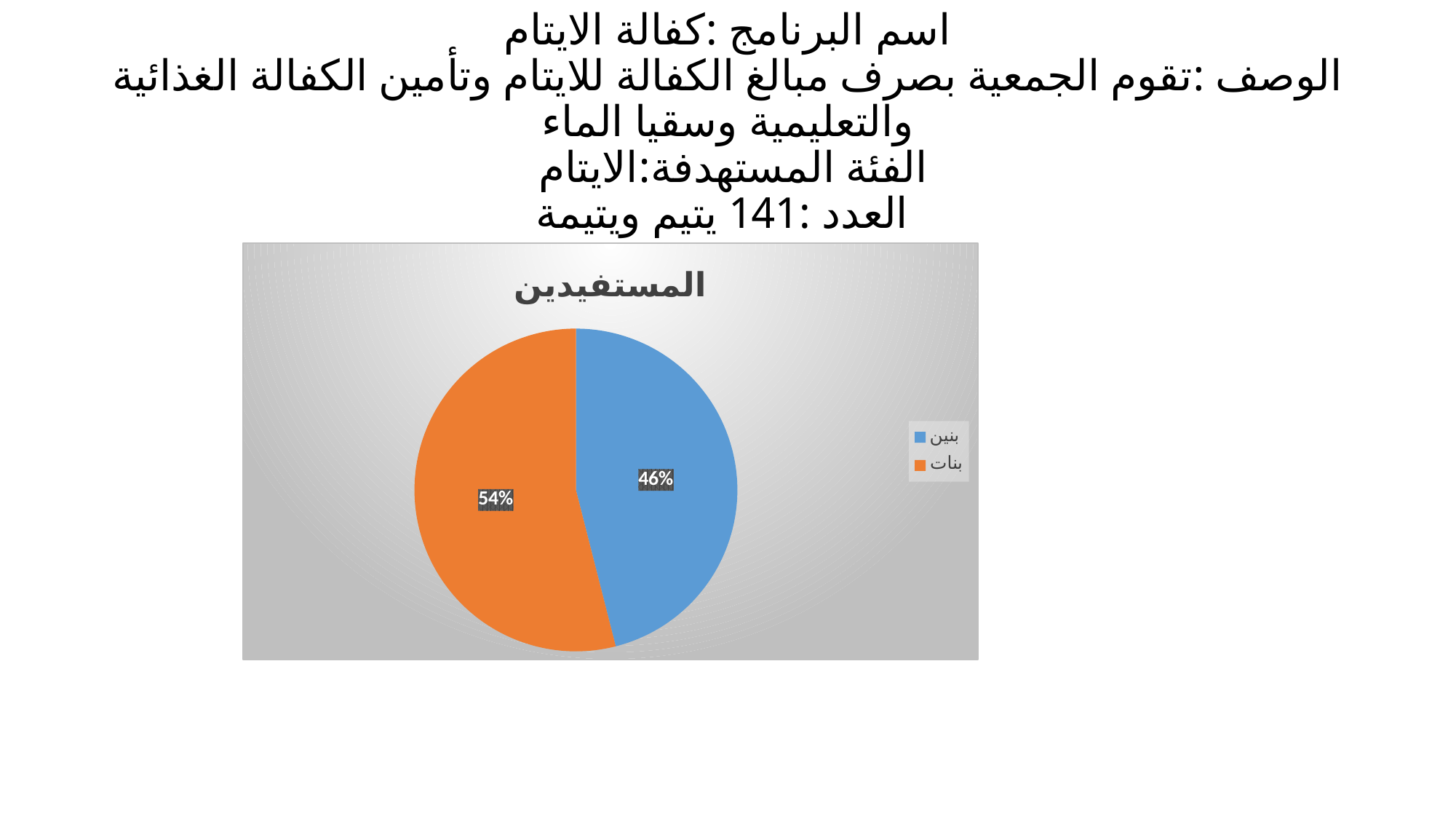
What share of the pie does بنات (girls) represent? 54% Which slice is larger, بنين or بنات? بنات What share of the pie does بنين (boys) represent? 46% What kind of chart is shown on the slide? pie chart Which category has the smallest slice of the pie? بنين Which category has the largest slice of the pie? بنات How many entries does the legend list? 2 What is the difference in percentage points between the بنات slice and the بنين slice? 8% What colour is the بنات slice? orange How many slices does the pie chart have? 2 What is the title of the chart? المستفيدين